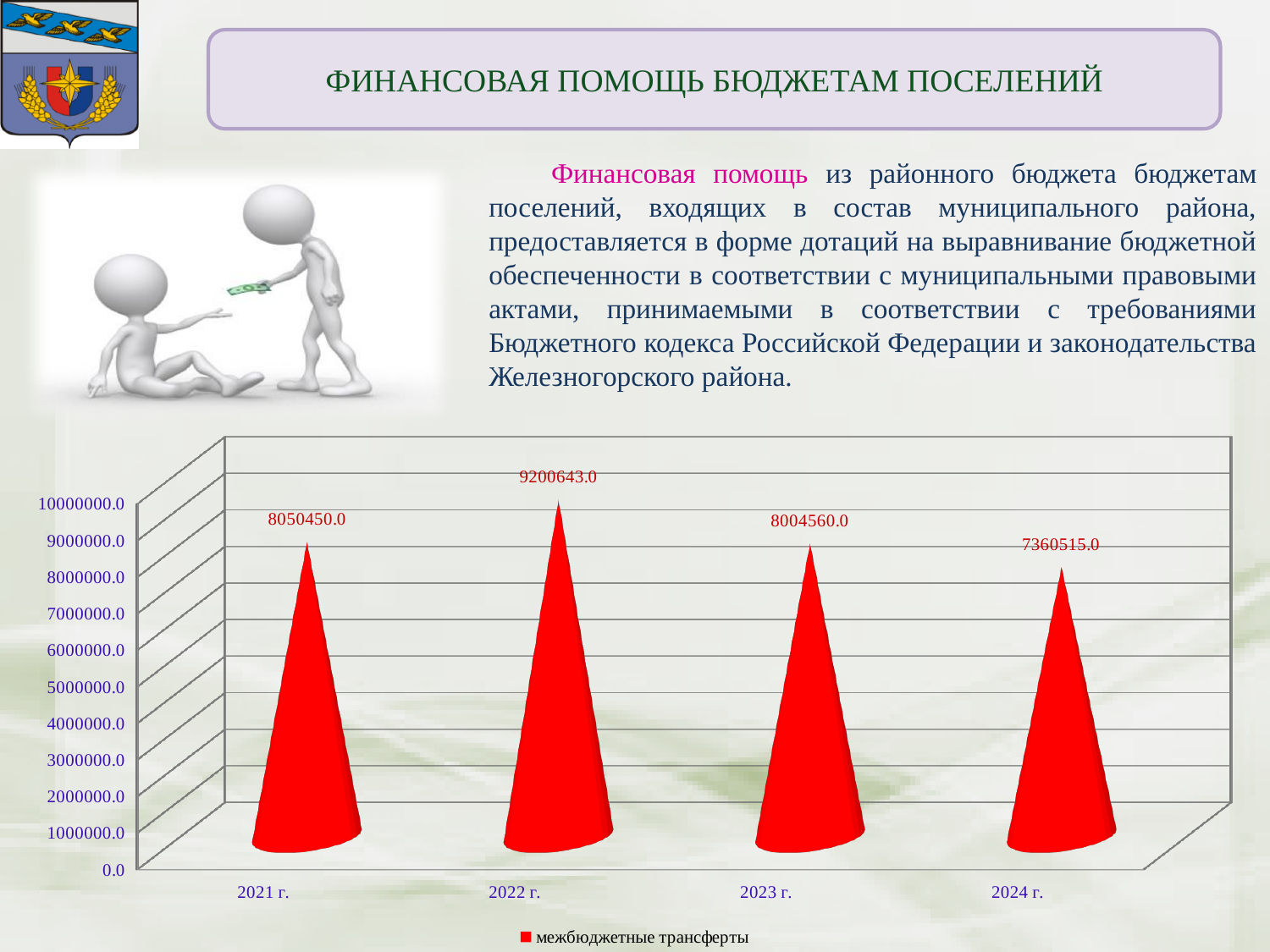
What series name does the legend show? межбюджетные трансферты Which is larger, the value for 2021 г. or the value for 2024 г.? 2021 г. What is the value for 2024 г.? 7360515.0 What is the value for 2021 г.? 8050450.0 What is the value for 2022 г.? 9200643.0 What is the difference between the values for 2022 г. and 2021 г.? 1150193.0 Which year has the lowest value? 2024 г. Which year has the highest value? 2022 г. What is the value for 2023 г.? 8004560.0 How many years are shown on the x axis? 4 What kind of chart is shown on the slide? bar chart What is the difference between the values for 2023 г. and 2024 г.? 644045.0